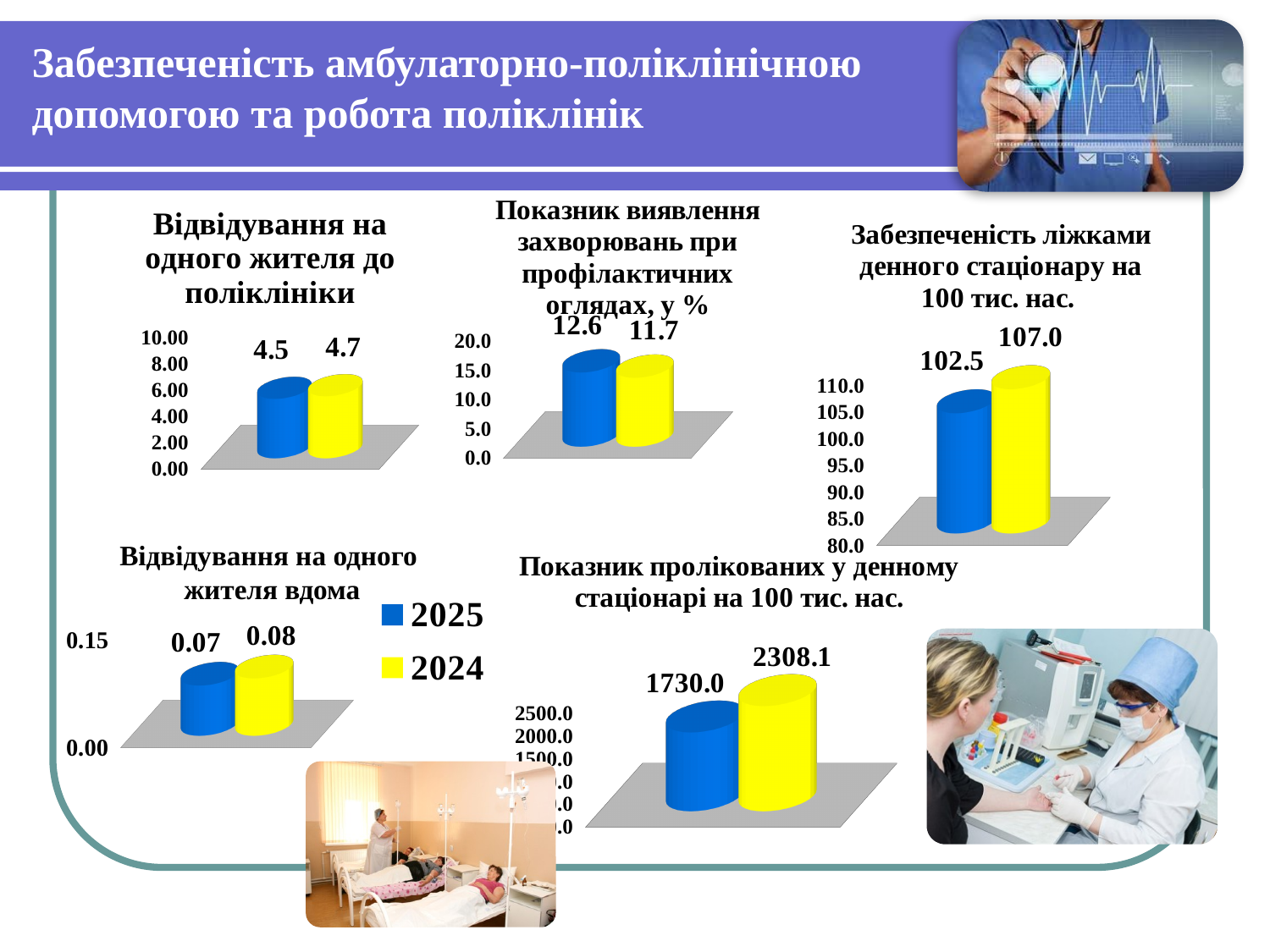
In the chart 'Показник пролікованих у денному стаціонарі на 100 тис. нас.', what is the value for 2024? 2308.1 In the chart 'Забезпеченість ліжками денного стаціонару на 100 тис. нас.', what is the value for 2024? 107.0 What kind of chart is 'Відвідування на одного жителя до поліклініки'? Bar chart In the chart 'Забезпеченість ліжками денного стаціонару на 100 тис. нас.', what is the difference between the 2024 and 2025 values? 4.5 In the chart 'Відвідування на одного жителя вдома', what is the value for 2025? 0.07 How many series does the shared legend on the slide list? 2 In the chart 'Показник виявлення захворювань при профілактичних оглядах, у %', what is the value for 2025? 12.6 In the chart 'Показник пролікованих у денному стаціонарі на 100 тис. нас.', which year has the lower value? 2025 In the chart 'Відвідування на одного жителя до поліклініки', what is the value for 2024? 4.7 In the chart 'Показник пролікованих у денному стаціонарі на 100 тис. нас.', what is the difference between the 2024 and 2025 values? 578.1 In the chart 'Показник виявлення захворювань при профілактичних оглядах, у %', which year has the higher value, 2025 or 2024? 2025 In the chart 'Відвідування на одного жителя до поліклініки', what is the value for 2025? 4.5